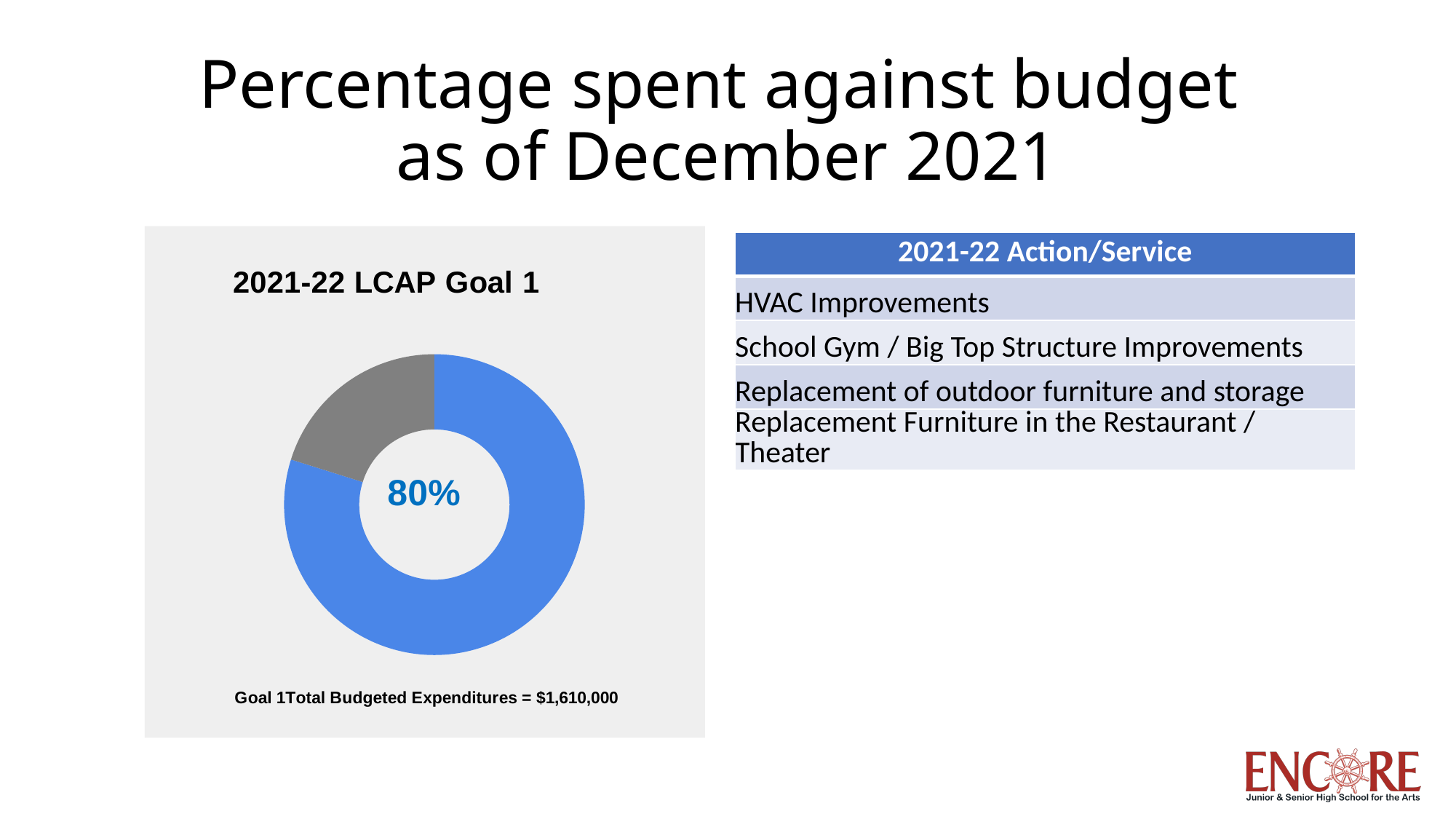
What is the title of the chart? 2021-22 LCAP Goal 1 Is the grey segment of the doughnut chart greater or less than 50% of the whole? less What is the Goal 1 total budgeted expenditures figure printed below the chart? $1,610,000 What percentage is shown in the centre of the doughnut chart? 80% What share of the doughnut does the blue segment represent? 80% What kind of chart is shown on the slide? Doughnut (pie) chart Is the blue segment of the doughnut chart greater or less than 50% of the whole? greater How many segments does the doughnut chart have? 2 Which segment of the doughnut chart is larger, the blue one or the grey one? Blue